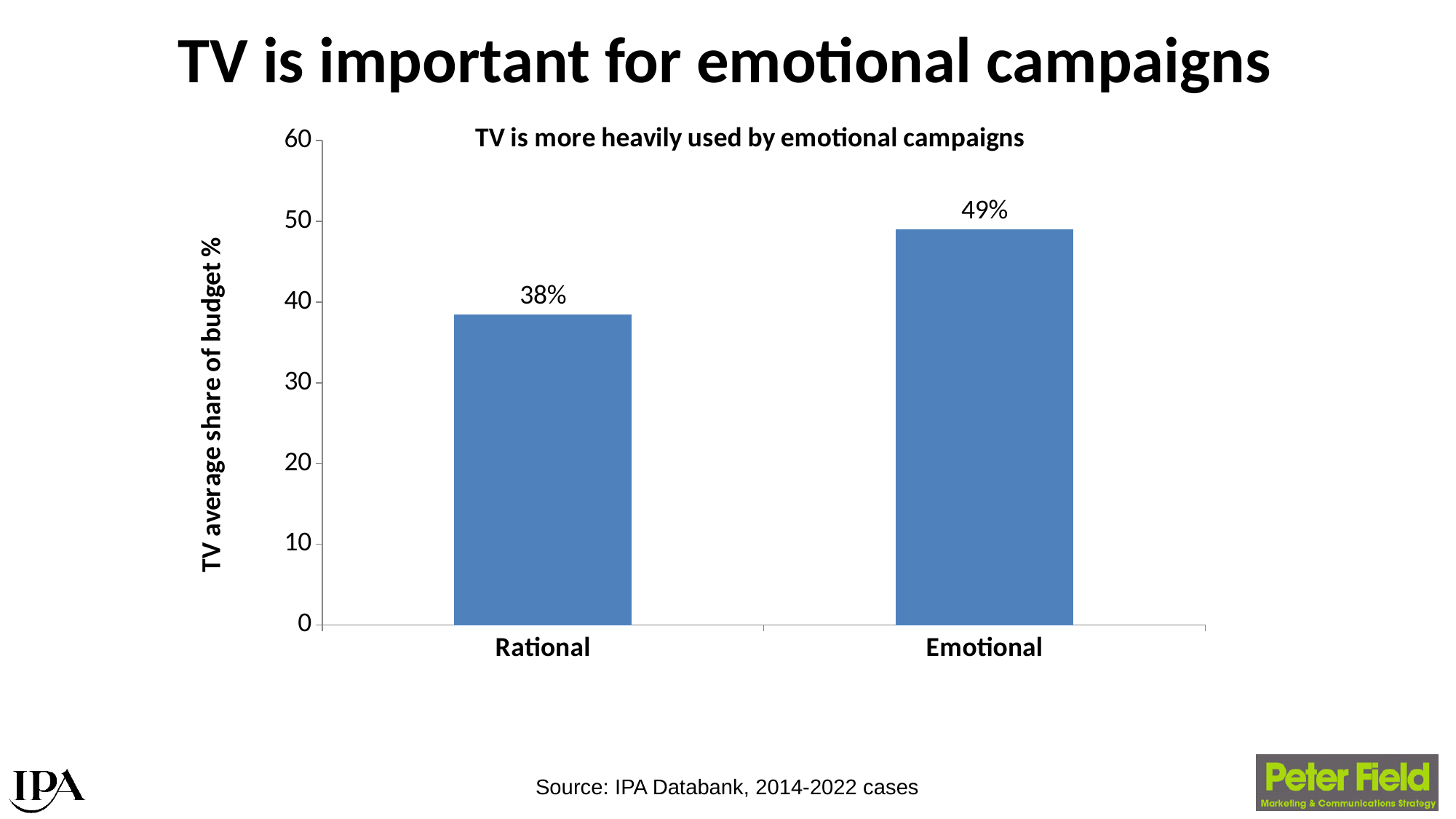
What is the label of the vertical axis? TV average share of budget % Is the value for Rational greater or less than 40? less Is the value for Emotional greater or less than 40? greater Which category has the highest TV average share of budget? Emotional What is the TV average share of budget for Emotional campaigns? 49% What is the title of the chart? TV is more heavily used by emotional campaigns How many categories are shown on the chart? 2 What is the difference in TV average share of budget between Emotional and Rational campaigns? 11% Which category has the lowest TV average share of budget? Rational Which is larger, the TV share of budget for Rational or for Emotional campaigns? Emotional What is the TV average share of budget for Rational campaigns? 38% What kind of chart is shown on the slide? Bar chart